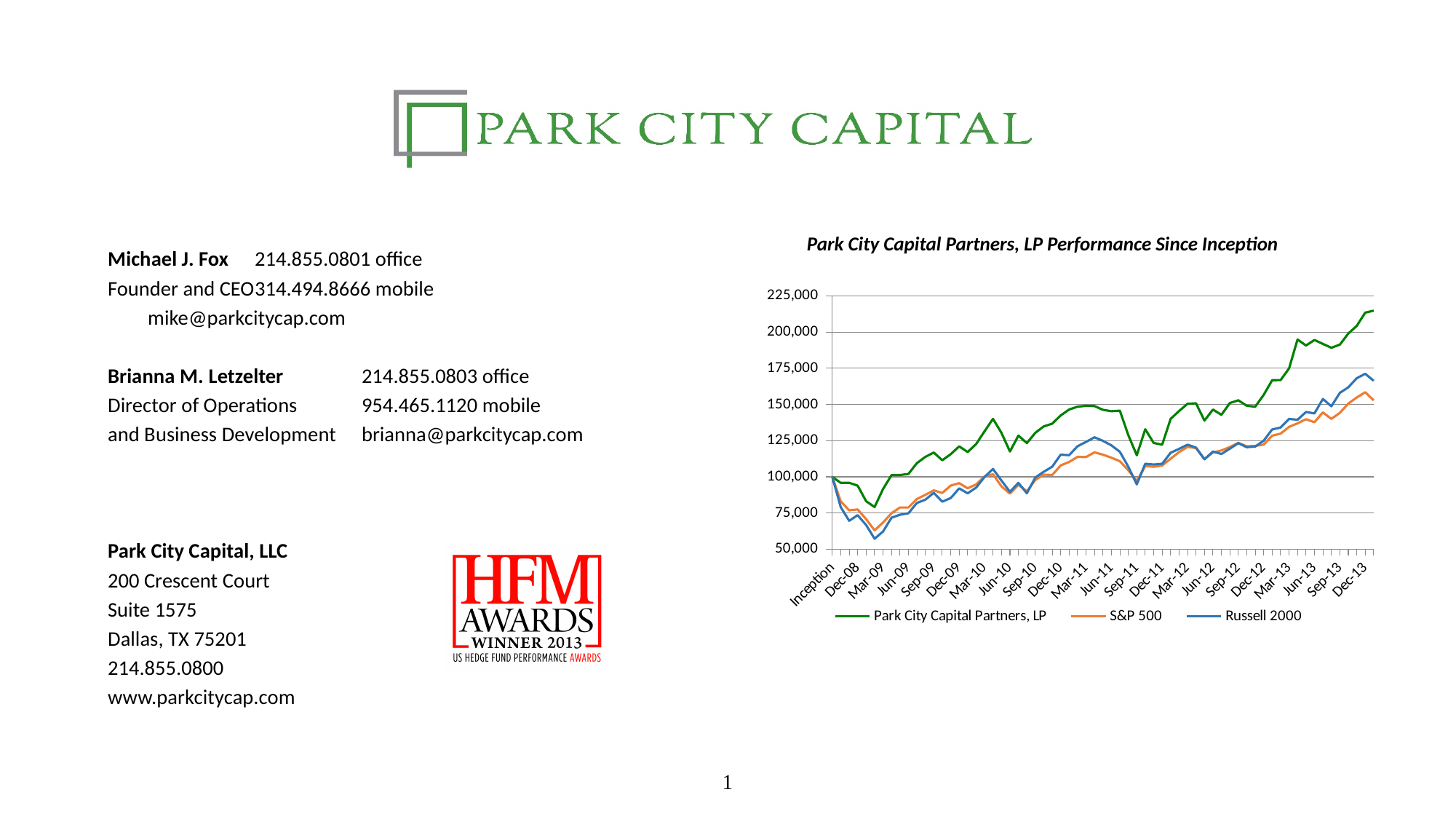
Which series has the highest value at Dec-13? Park City Capital Partners, LP Is the value for Park City Capital Partners, LP at Sep-11 greater or less than 100,000? greater Is the value for Russell 2000 at Mar-09 greater or less than 75,000? less At what value do all three series start at Inception? 100,000 At Dec-13, which is larger: Russell 2000 or S&P 500? Russell 2000 How many series does the chart legend list? 3 Is the value for Park City Capital Partners, LP at Dec-13 greater or less than 200,000? greater Does the Park City Capital Partners, LP line rise or fall overall from Inception to Dec-13? rise What kind of chart is shown on the slide? line chart Which series is drawn with the green line? Park City Capital Partners, LP What is the title of the chart? Park City Capital Partners, LP Performance Since Inception